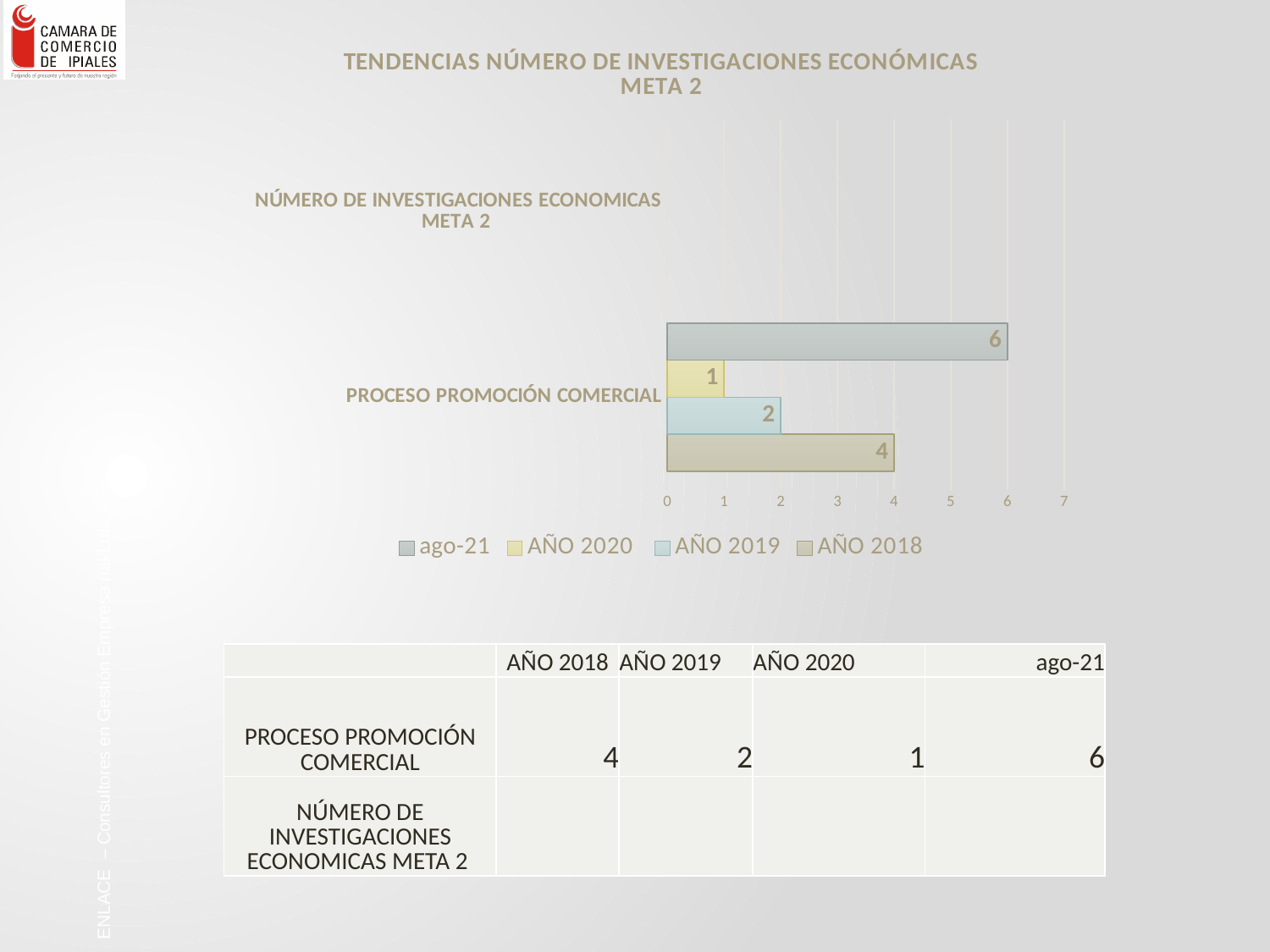
How many series does the legend list? 4 What is the difference between the ago-21 value and the AÑO 2018 value? 2 What is the value for AÑO 2018 for PROCESO PROMOCIÓN COMERCIAL? 4 Which series has the highest value for PROCESO PROMOCIÓN COMERCIAL? ago-21 What is the value for ago-21 for PROCESO PROMOCIÓN COMERCIAL? 6 What is the title of the chart? TENDENCIAS NÚMERO DE INVESTIGACIONES ECONÓMICAS META 2 What is the value for AÑO 2020 for PROCESO PROMOCIÓN COMERCIAL? 1 Which series has the lowest value for PROCESO PROMOCIÓN COMERCIAL? AÑO 2020 Is the value for ago-21 greater or less than 5? greater What is the value for AÑO 2019 for PROCESO PROMOCIÓN COMERCIAL? 2 Which is larger, the AÑO 2019 value or the AÑO 2018 value? AÑO 2018 What kind of chart is shown on the slide? Bar chart